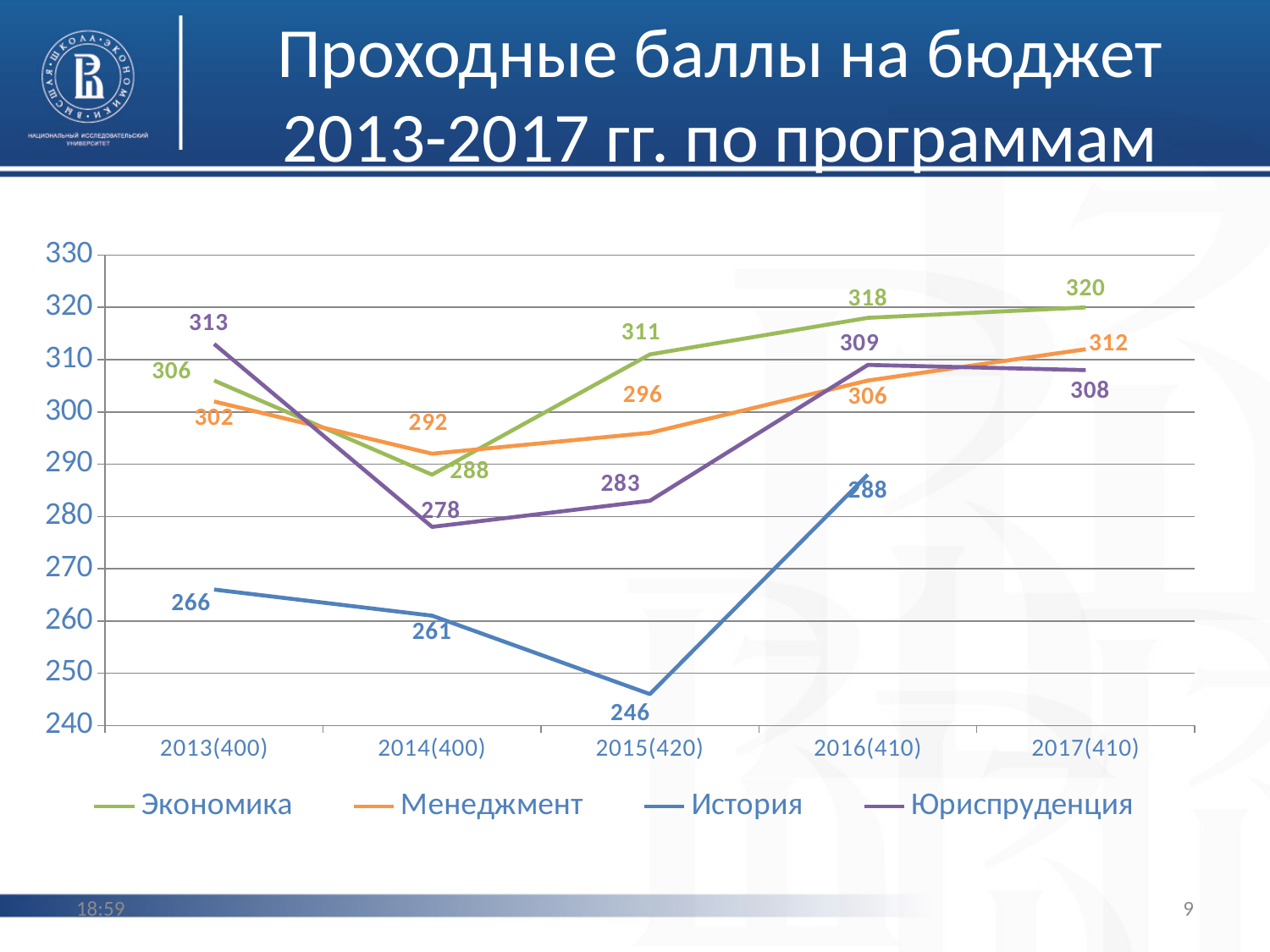
What type of chart is shown on the slide? line chart What is the value for История in 2015(420)? 246 What is the value for Юриспруденция in 2014(400)? 278 How many series does the legend list? 4 How many years are shown on the x axis? 5 What is the value for Менеджмент in 2016(410)? 306 What is the difference between Экономика and Менеджмент in 2015(420)? 15 Which is larger in 2016(410): Юриспруденция or Менеджмент? Юриспруденция Does the value for Менеджмент rise or fall from 2014(400) to 2017(410)? rise Which series has the highest value in 2013(400)? Юриспруденция What is the value for Экономика in 2017(410)? 320 In which year is the value for Экономика lowest? 2014(400)